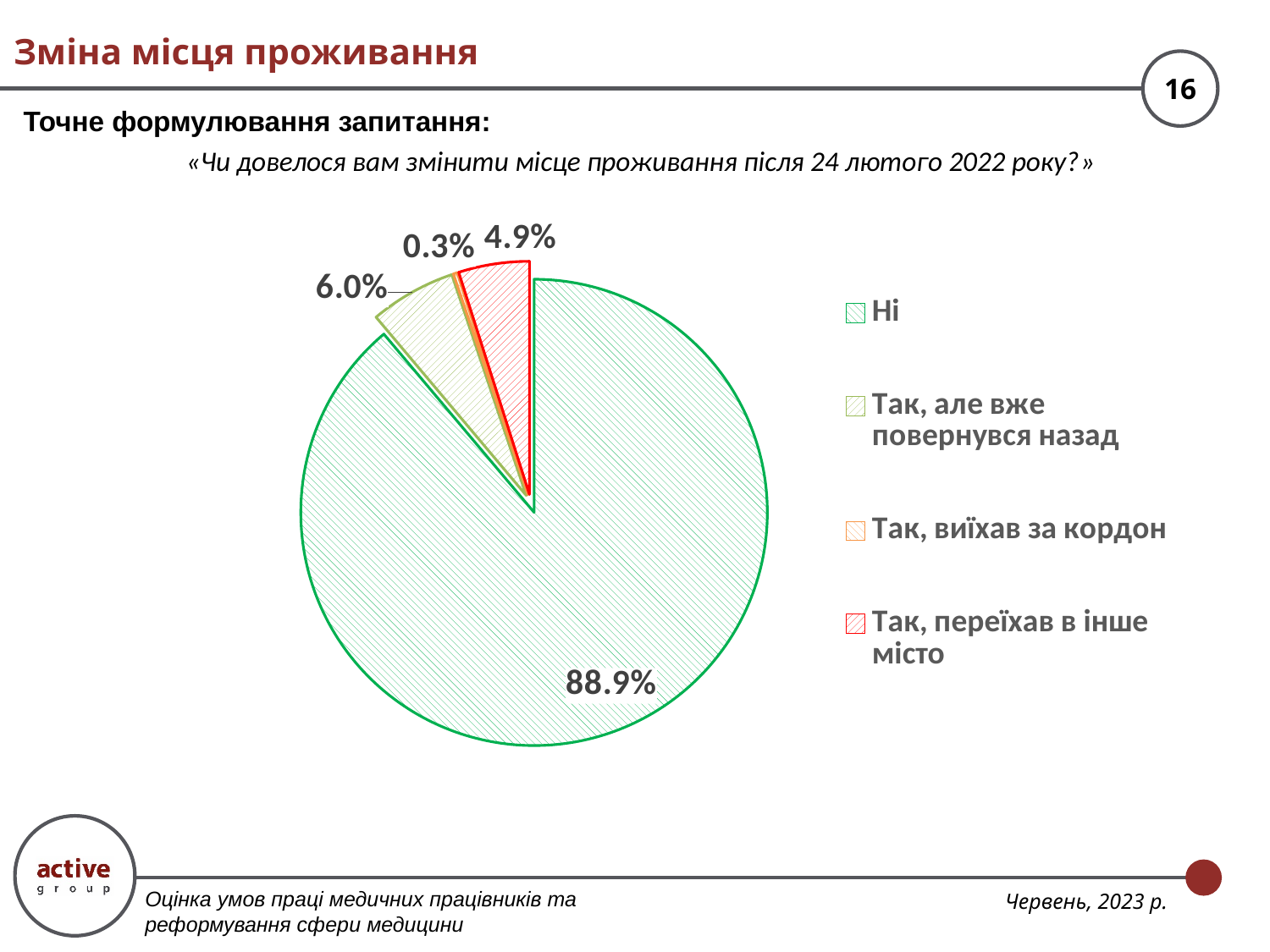
What share of respondents answered «Так, переїхав в інше місто»? 4.9% What is the combined share of all respondents who answered «Так» in any form? 11.2% Which legend entry is shown with red hatching? Так, переїхав в інше місто Which answer option has the smallest share of the pie? Так, виїхав за кордон Which answer option has the largest share of the pie? Ні What share of respondents answered «Так, але вже повернувся назад»? 6.0% What share of respondents answered «Ні»? 88.9% What share of respondents answered «Так, виїхав за кордон»? 0.3% What is the difference in percentage points between «Так, але вже повернувся назад» and «Так, переїхав в інше місто»? 1.1 What type of chart is shown on the slide? Pie chart Which is larger: the share for «Так, переїхав в інше місто» or for «Так, виїхав за кордон»? Так, переїхав в інше місто How many slices does the pie chart have? 4